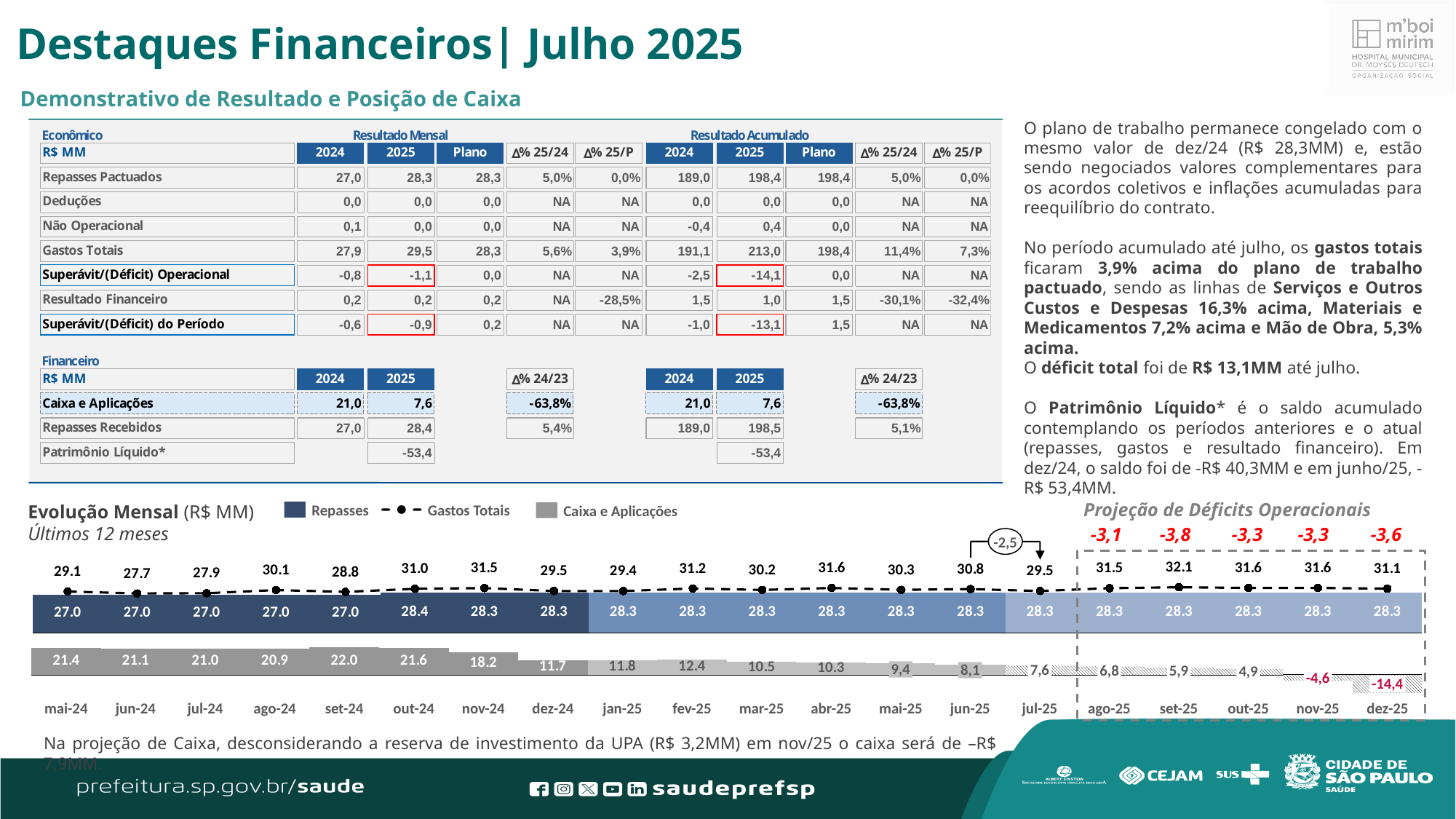
In the Evolução Mensal chart, which month has the lowest Caixa e Aplicações value? dez-25 In the Evolução Mensal chart, is Gastos Totais higher in jun-24 or in jul-24? jul-24 In the Evolução Mensal chart, which month has the lowest Gastos Totais value? jun-24 In the Evolução Mensal chart, what is the value of Gastos Totais for nov-24? 31.5 In the Evolução Mensal chart, what is the value of Repasses for out-24? 28.4 In the Evolução Mensal chart, what is the difference between Gastos Totais in set-25 and in mai-24? 3.0 How many months are shown on the x axis of the Evolução Mensal chart? 20 In the Projeção de Déficits Operacionais section of the chart, what is the projected deficit for set-25? -3,8 In the Evolução Mensal chart, which month has the highest Gastos Totais value? set-25 How many series does the legend of the Evolução Mensal chart list? 3 In the Evolução Mensal chart, what is the value of Caixa e Aplicações for jul-25? 7,6 In the Evolução Mensal chart, does Caixa e Aplicações rise or fall from mai-24 to dez-25? fall